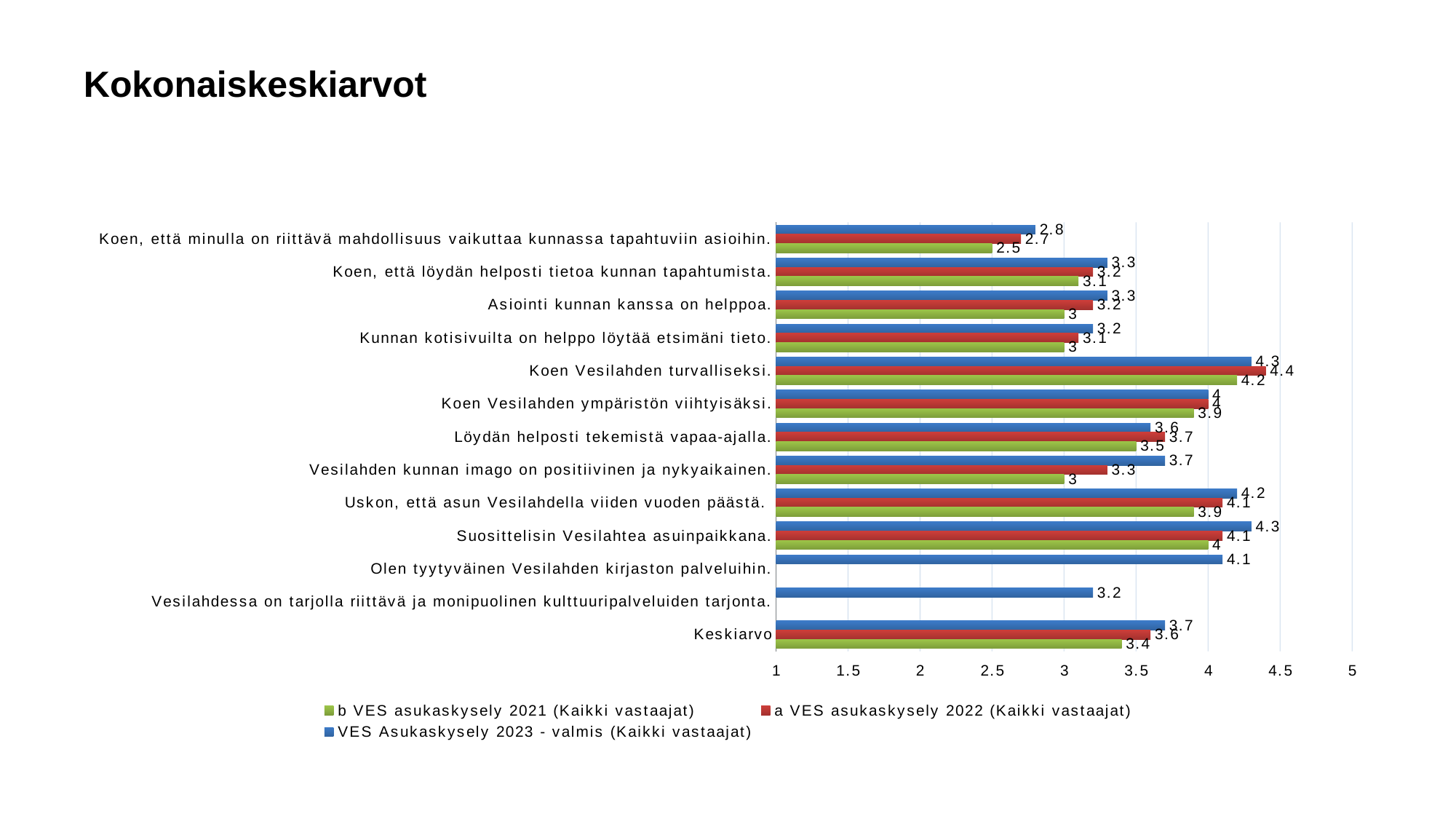
What is the value for 'Keskiarvo' in the VES Asukaskysely 2023 - valmis (Kaikki vastaajat) series? 3.7 What is the value for 'Koen Vesilahden turvalliseksi.' in the a VES asukaskysely 2022 (Kaikki vastaajat) series? 4.4 Which category has the lowest value in the b VES asukaskysely 2021 (Kaikki vastaajat) series? Koen, että minulla on riittävä mahdollisuus vaikuttaa kunnassa tapahtuviin asioihin. Is the value for 'Vesilahdessa on tarjolla riittävä ja monipuolinen kulttuuripalveluiden tarjonta.' in the 2023 series greater or less than 3.5? less What is the value for 'Olen tyytyväinen Vesilahden kirjaston palveluihin.' in the VES Asukaskysely 2023 - valmis (Kaikki vastaajat) series? 4.1 For 'Löydän helposti tekemistä vapaa-ajalla.', which is larger: the a VES asukaskysely 2022 value or the VES Asukaskysely 2023 - valmis value? a VES asukaskysely 2022 (Kaikki vastaajat) Which category has the highest value in the a VES asukaskysely 2022 (Kaikki vastaajat) series? Koen Vesilahden turvalliseksi. What type of chart is shown on the slide? bar chart What is the title of the chart on the slide? Kokonaiskeskiarvot What is the difference between the 2023 and 2021 values for 'Vesilahden kunnan imago on positiivinen ja nykyaikainen.'? 0.7 How many categories are shown on the vertical axis of the chart? 13 How many series does the legend list? 3